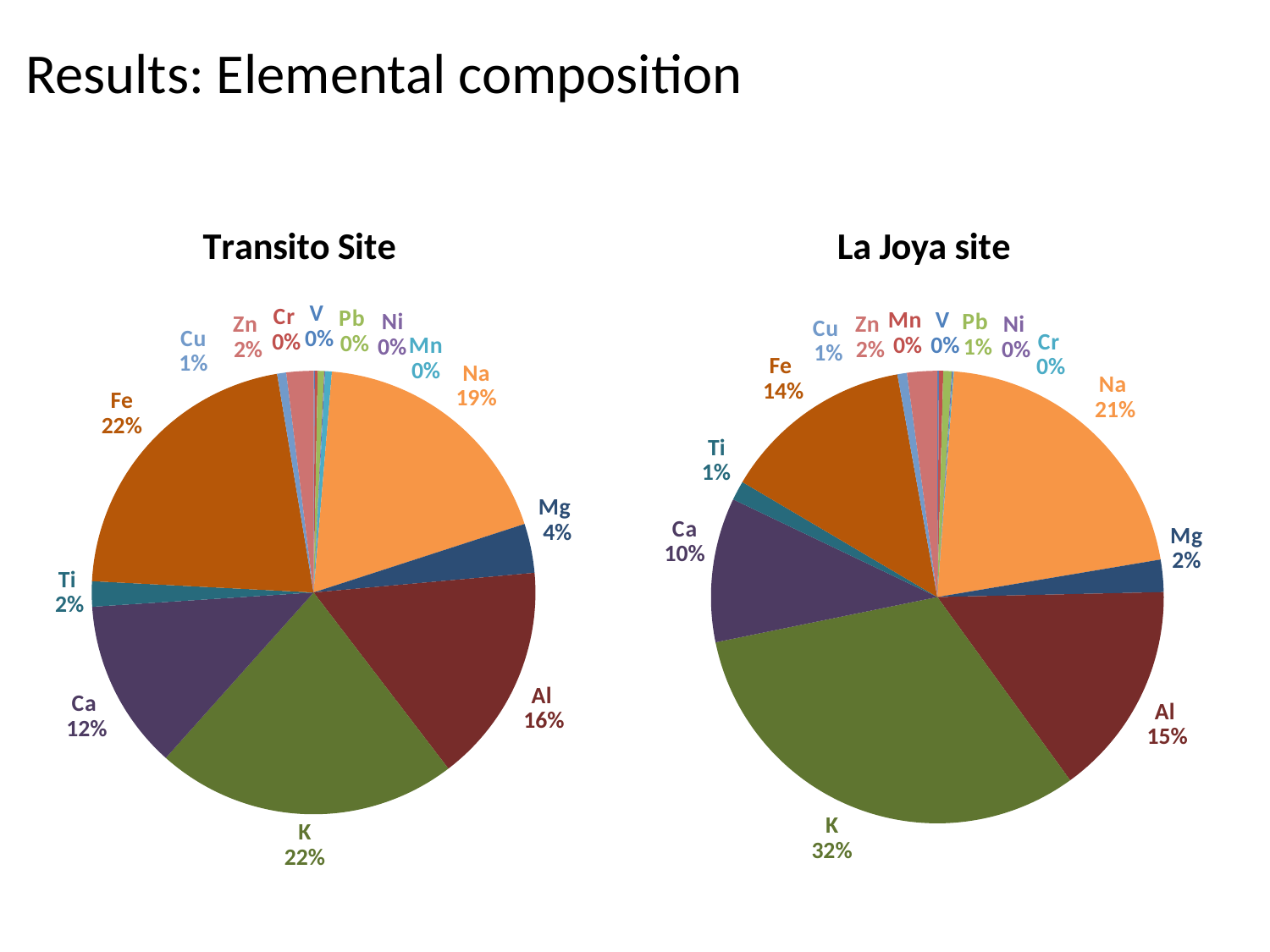
What is the title of the chart on the left of the slide? Transito Site In the La Joya site chart, which is larger, the share for Na or the share for Ca? Na How many elements are shown in the Transito Site chart? 14 In the Transito Site chart, what share does Na have? 19% In the Transito Site chart, what is the difference between the shares of Fe and Na? 3% In the Transito Site chart, what is the share for Ca? 12% In the La Joya site chart, what is the share for Fe? 14% In the La Joya site chart, what share does K have? 32% What kind of chart is the La Joya site chart? Pie chart In the Transito Site chart, which is larger, the share for Al or the share for Ca? Al In the La Joya site chart, which element has the largest share? K In the La Joya site chart, what is the difference between the shares of K and Al? 17%